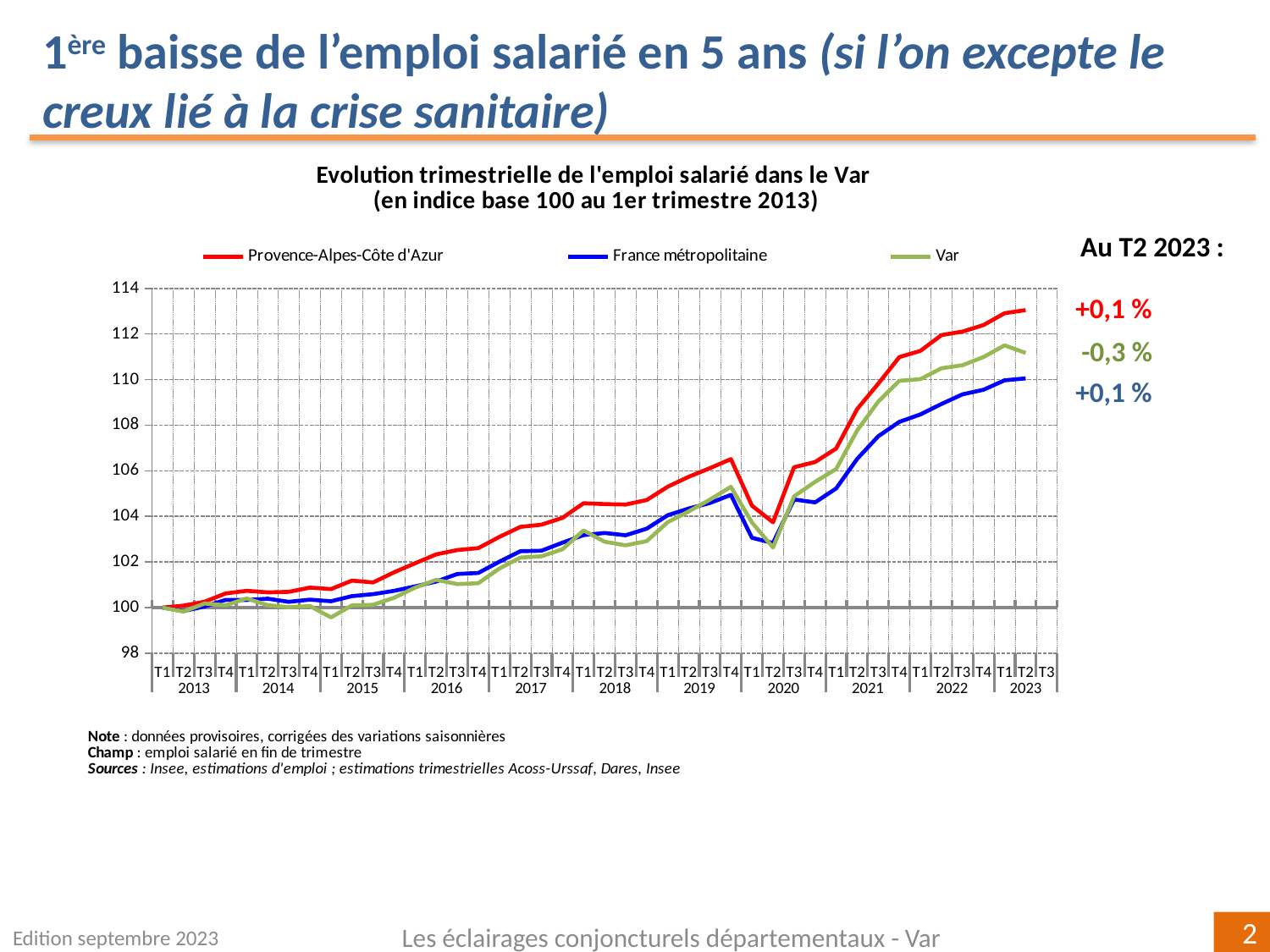
What is the title of the chart? Evolution trimestrielle de l'emploi salarié dans le Var (en indice base 100 au 1er trimestre 2013) Over the whole period from T1 2013 to T2 2023, does the Provence-Alpes-Côte d'Azur index generally rise or fall? rise According to the annotation 'Au T2 2023', what is the quarterly change for Var? -0,3 % How many series does the chart legend list? 3 Is the value for France métropolitaine at T2 2020 greater or less than 104? less Which series has the lowest index value at T2 2023? France métropolitaine Which series has the highest index value at T2 2023? Provence-Alpes-Côte d'Azur Is the value for Provence-Alpes-Côte d'Azur at T2 2023 greater or less than 112? greater What kind of chart is shown on the slide? line chart Is the value for Var at T2 2023 greater or less than 112? less According to the annotation 'Au T2 2023', what is the quarterly change for Provence-Alpes-Côte d'Azur? +0,1 % Which series is drawn in green on the chart? Var